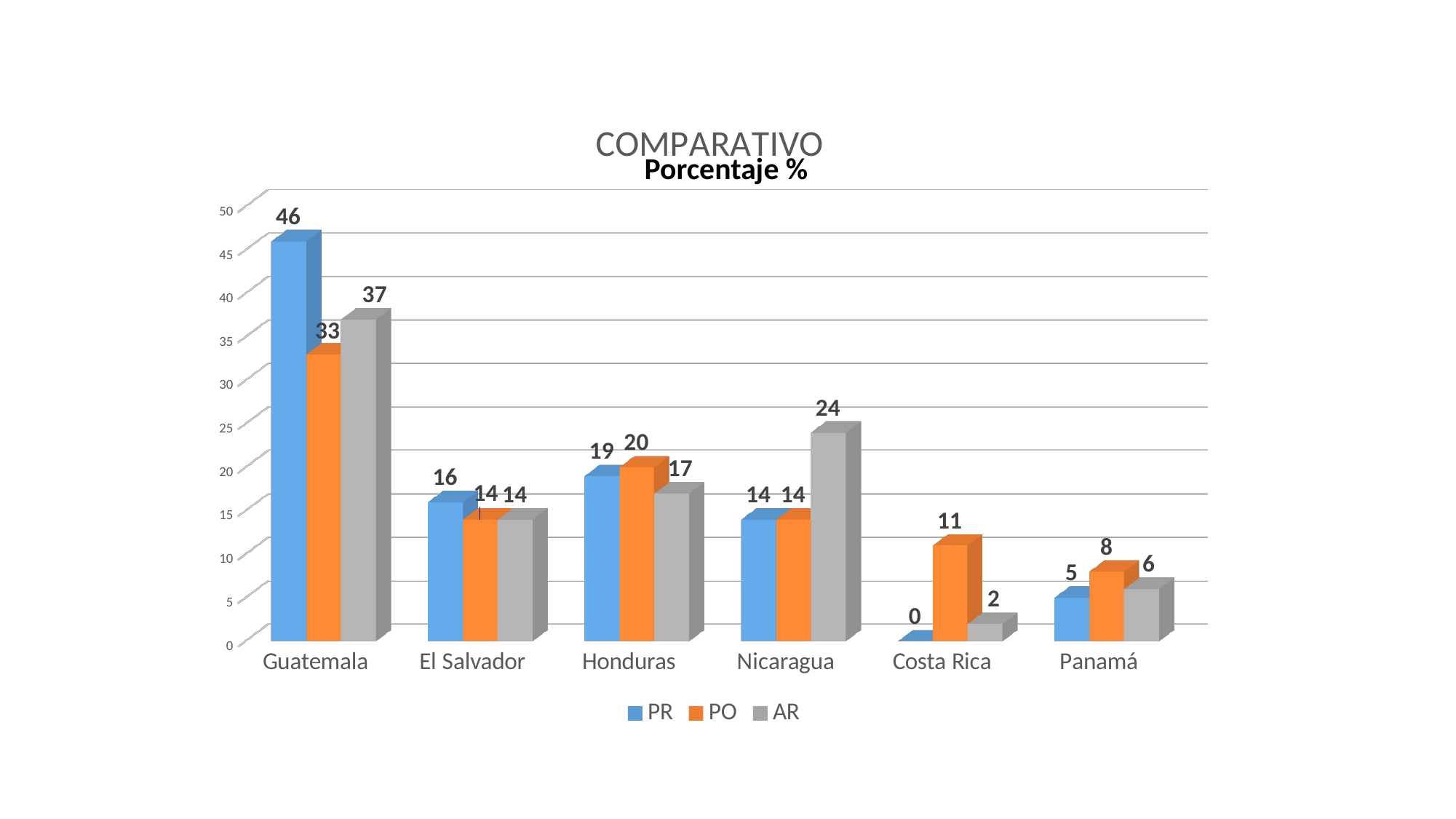
What is the PR value for Guatemala? 46 What is the AR value for Nicaragua? 24 What is the title of the chart? COMPARATIVO How many countries are shown on the x axis? 6 Which series is shown in orange? PO What is the difference between the PR and PO values for Guatemala? 13 What kind of chart is shown on the slide? Bar chart How many series does the legend list? 3 Which country has the highest PR value? Guatemala Which country has the lowest PR value? Costa Rica Which is larger for Honduras, the PO value or the AR value? PO What is the PO value for Costa Rica? 11